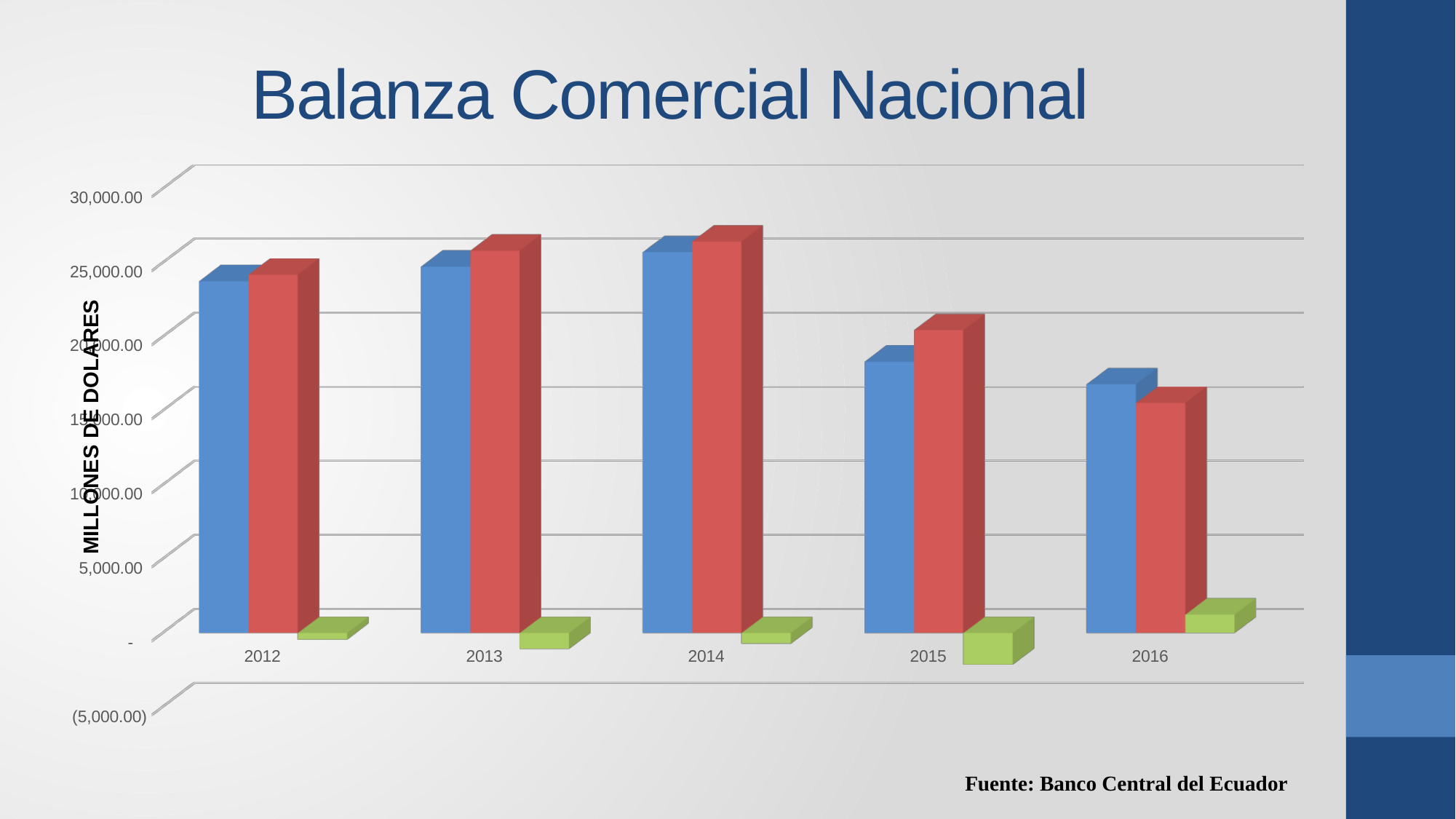
Do the blue bars rise or fall from 2014 to 2016? Fall What is the label on the vertical axis of the chart? MILLONES DE DOLARES In 2015, which bar is taller, the blue bar or the red bar? Red Is the value of the blue bar for 2015 greater or less than 20,000.00? less In 2016, which bar is taller, the blue bar or the red bar? Blue What kind of chart is shown on the slide? Bar chart In which year is the blue bar the highest? 2014 What is the title of the chart? Balanza Comercial Nacional In which year is the green bar the lowest (most negative)? 2015 How many years are shown on the x axis of the chart? 5 In which year is the red bar the highest? 2014 Is the value of the red bar for 2014 greater or less than 25,000.00? greater